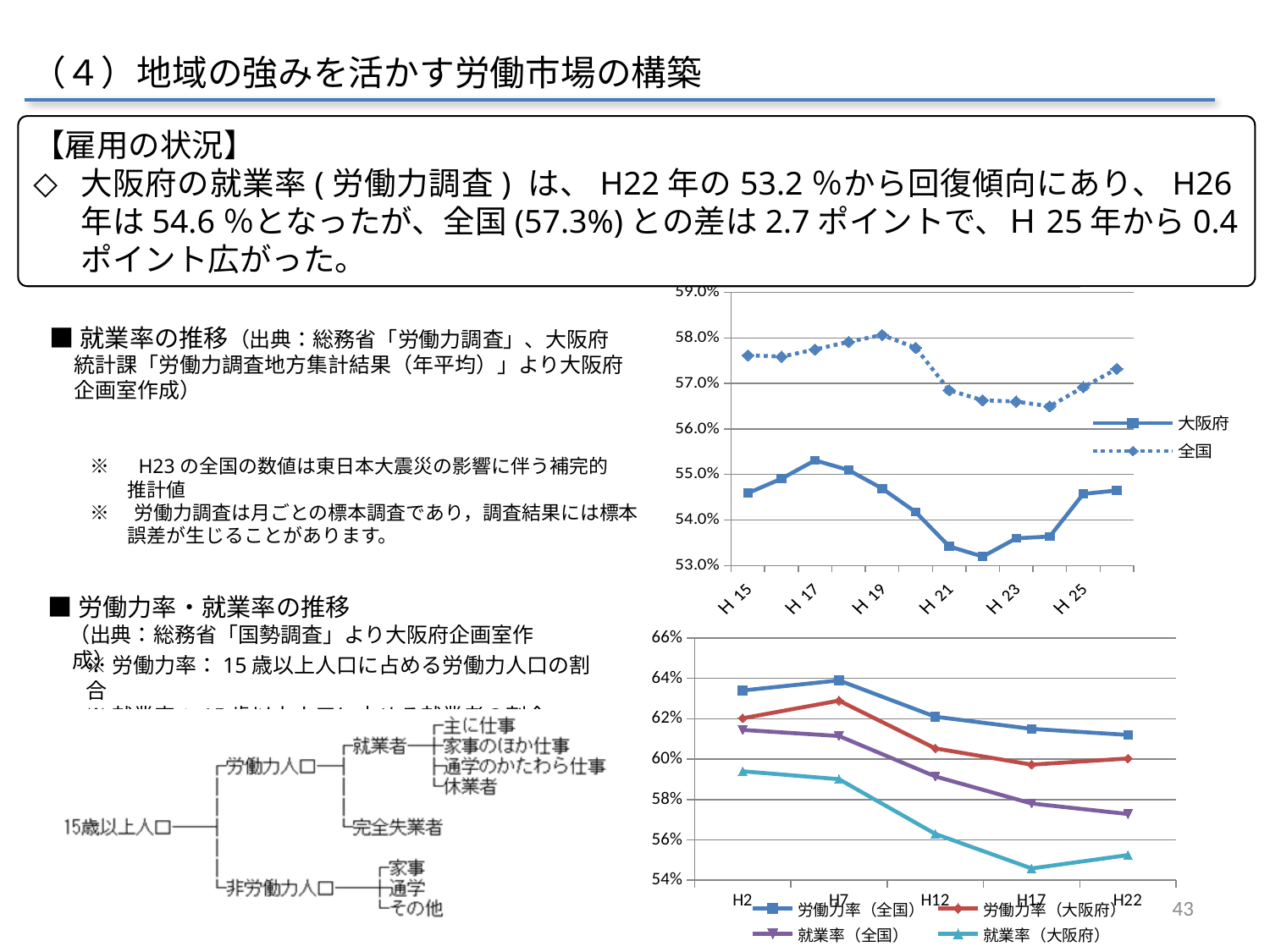
What kind of chart is the top chart (就業率の推移)? line chart How many series does the legend of the bottom chart (労働力率・就業率の推移) list? 4 In the bottom chart (労働力率・就業率の推移), which series has the lowest value at H17? 就業率（大阪府） In the top chart (就業率の推移), which series is higher at H26, 大阪府 or 全国? 全国 In the bottom chart (労働力率・就業率の推移), is the value for 労働力率（全国） at H7 greater or less than 62%? greater How many points are plotted along the x axis for each series in the bottom chart (労働力率・就業率の推移)? 5 In the top chart (就業率の推移), in which year is the 大阪府 series at its lowest? H22 In the bottom chart (労働力率・就業率の推移), does 労働力率（全国） rise or fall from H2 to H22? fall In the top chart (就業率の推移), in which year is the 大阪府 series at its highest? H17 In the top chart (就業率の推移), is the value for 全国 at H23 greater or less than 57.0%? less In the top chart (就業率の推移), is the value for 大阪府 at H22 greater or less than 54.0%? less How many series does the legend of the top chart (就業率の推移) list? 2